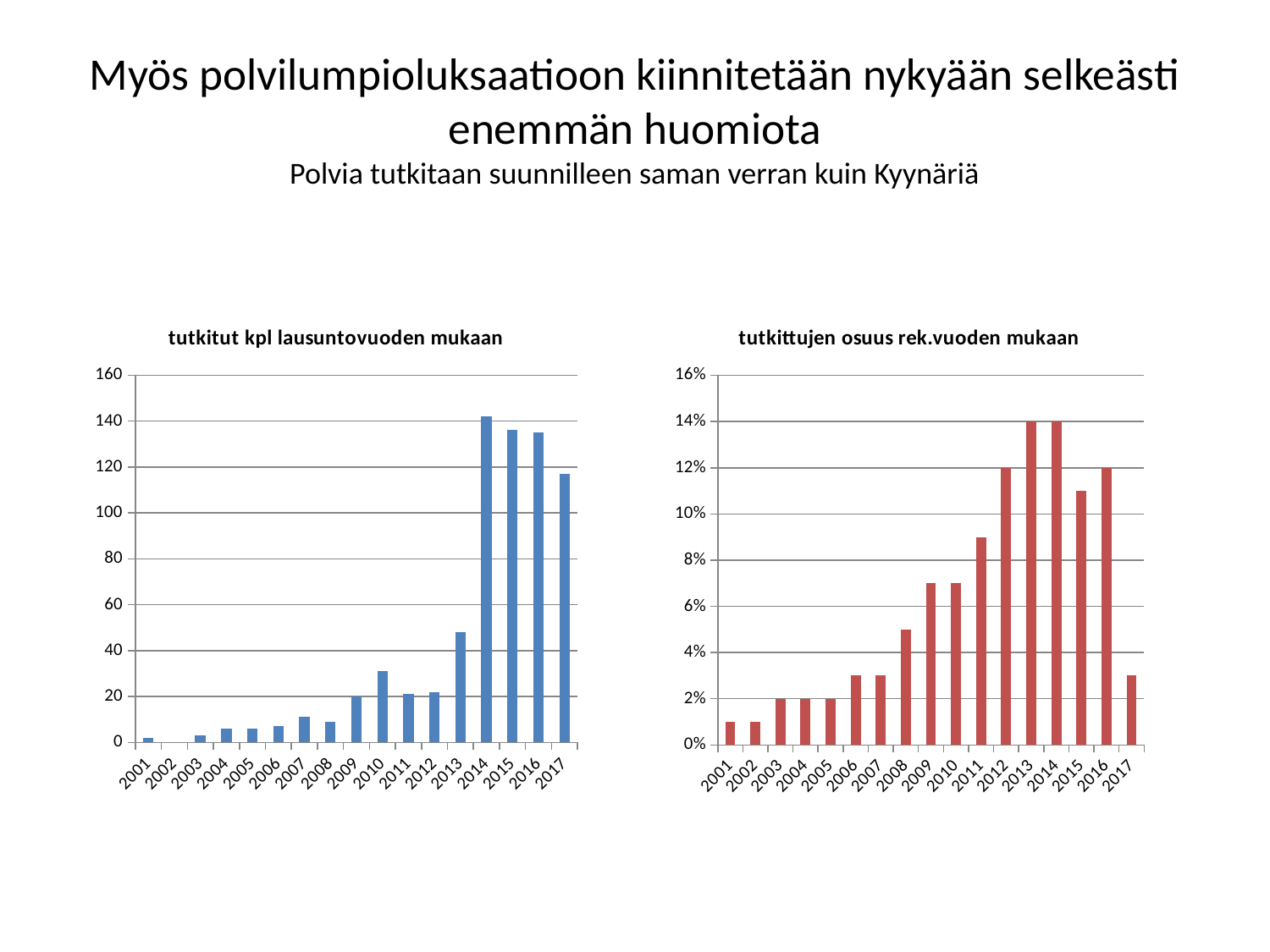
In the right chart 'tutkittujen osuus rek.vuoden mukaan', what is the value for 2012? 12% What kind of chart is the left chart titled 'tutkitut kpl lausuntovuoden mukaan'? bar chart In the right chart 'tutkittujen osuus rek.vuoden mukaan', which is larger, the value for 2015 or the value for 2017? 2015 In the left chart 'tutkitut kpl lausuntovuoden mukaan', which year has the highest value? 2014 In the left chart 'tutkitut kpl lausuntovuoden mukaan', which year has the lowest value? 2002 In the left chart 'tutkitut kpl lausuntovuoden mukaan', is the value for 2017 greater or less than 100? greater In the left chart 'tutkitut kpl lausuntovuoden mukaan', which is larger, the value for 2010 or the value for 2011? 2010 In the right chart 'tutkittujen osuus rek.vuoden mukaan', what is the value for 2003? 2% In the right chart 'tutkittujen osuus rek.vuoden mukaan', do the values generally rise or fall from 2001 to 2014? rise In the left chart 'tutkitut kpl lausuntovuoden mukaan', is the value for 2013 greater or less than 60? less How many years are shown on the x axis of the left chart 'tutkitut kpl lausuntovuoden mukaan'? 17